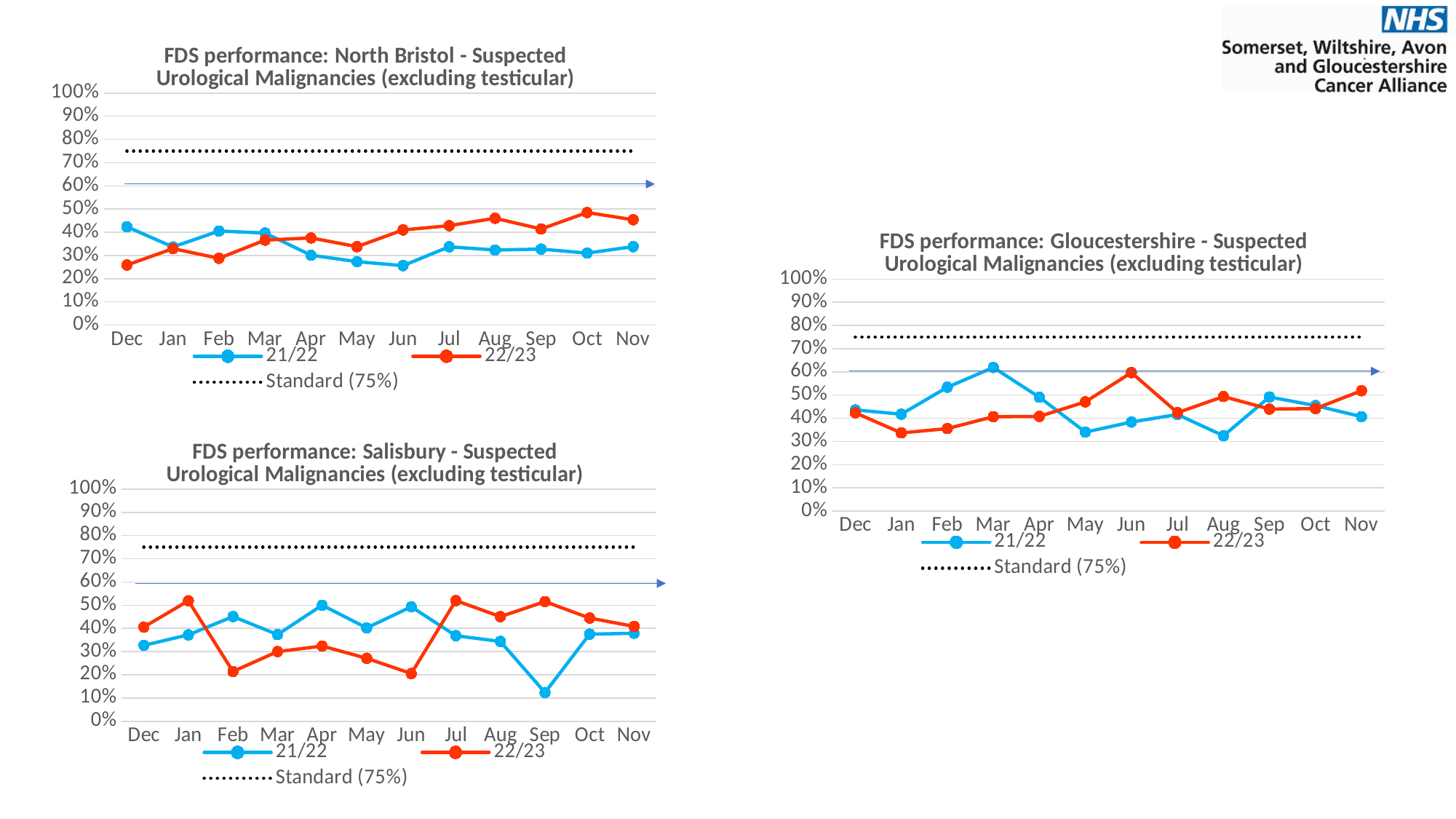
In the 'FDS performance: North Bristol' chart, is the 21/22 value for Jun greater or less than 30%? less In the 'FDS performance: Gloucestershire' chart, which month has the highest 22/23 value? Jun In the 'FDS performance: Salisbury' chart, is the 21/22 value for Sep greater or less than 20%? less How many series does the legend of the 'FDS performance: Gloucestershire' chart list? 3 How many months are plotted on the x axis of the 'FDS performance: Salisbury' chart? 12 What kind of chart is the 'FDS performance: North Bristol' chart? line chart In the 'FDS performance: Salisbury' chart, which series has the larger value in Feb, 21/22 or 22/23? 21/22 In the 'FDS performance: Gloucestershire' chart, is the 21/22 value for Aug greater or less than 40%? less In the 'FDS performance: Salisbury' chart, which month has the lowest 21/22 value? Sep In the 'FDS performance: North Bristol' chart, which series has the larger value in Nov, 21/22 or 22/23? 22/23 What value does the dotted 'Standard' line represent in the legend of the 'FDS performance: North Bristol' chart? 75% In the 'FDS performance: Gloucestershire' chart, which month has the highest 21/22 value? Mar